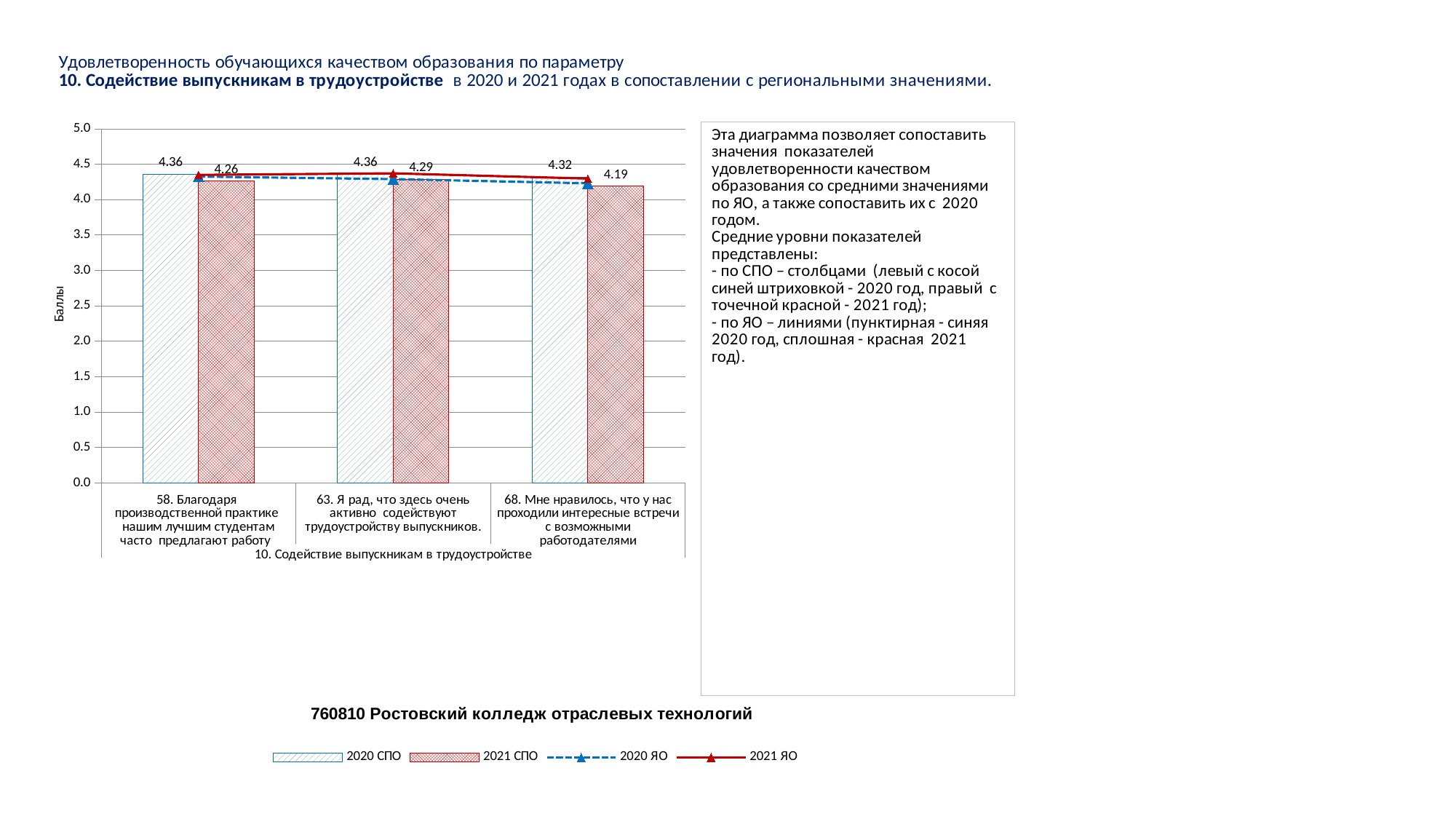
What is the label of the vertical axis? Баллы For category 58, which is larger: the 2020 СПО value or the 2021 СПО value? 2020 СПО Do the 2021 СПО values rise or fall from category 63 to category 68? fall Which category has the lowest 2021 СПО value? 68. Мне нравилось, что у нас проходили интересные встречи с возможными работодателями Is the 2021 СПО value for category 68 greater or less than 4.0? greater Which category has the highest 2021 СПО value? 63. Я рад, что здесь очень активно содействуют трудоустройству выпускников What is the difference between the 2020 СПО and 2021 СПО values for category 68? 0.13 What is the 2021 СПО value for category 63 (Я рад, что здесь очень активно содействуют трудоустройству выпускников)? 4.29 What is the 2020 СПО value for category 58 (Благодаря производственной практике нашим лучшим студентам часто предлагают работу)? 4.36 How many categories are shown on the x axis? 3 What is the 2021 СПО value for category 68 (Мне нравилось, что у нас проходили интересные встречи с возможными работодателями)? 4.19 How many series does the legend list? 4